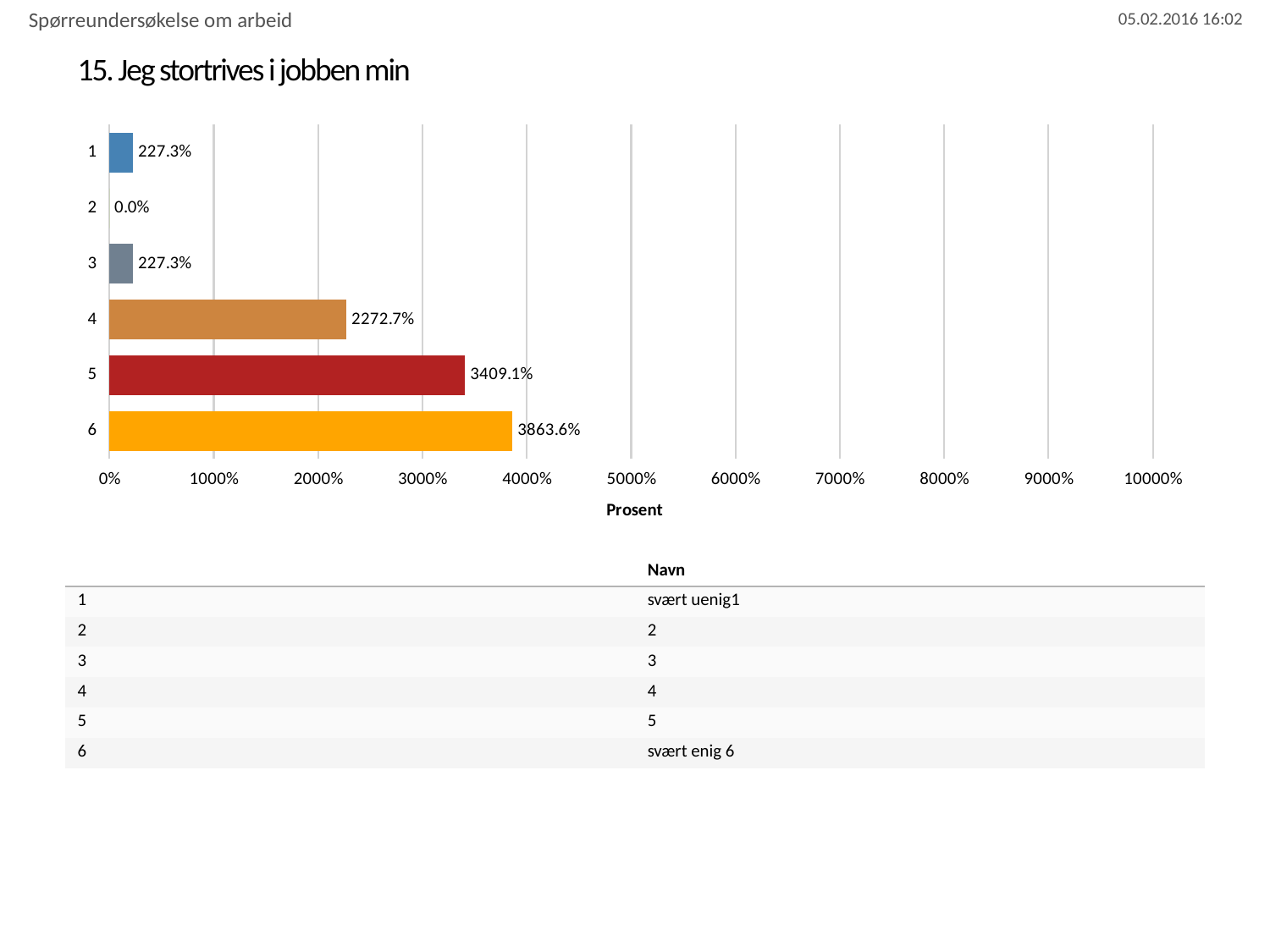
Is the value for category 6 greater or less than 3000%? greater What is the title of the chart? 15. Jeg stortrives i jobben min What kind of chart is shown? bar chart What is the value for category 4? 2272.7% What is the difference between the values for category 6 and category 5? 454.5% Which category has the highest value? 6 Which category has the lowest value? 2 Which is larger, the value for category 4 or the value for category 5? 5 What is the value for category 6? 3863.6% How many categories are shown on the chart? 6 What is the value for category 2? 0.0% What is the value for category 5? 3409.1%